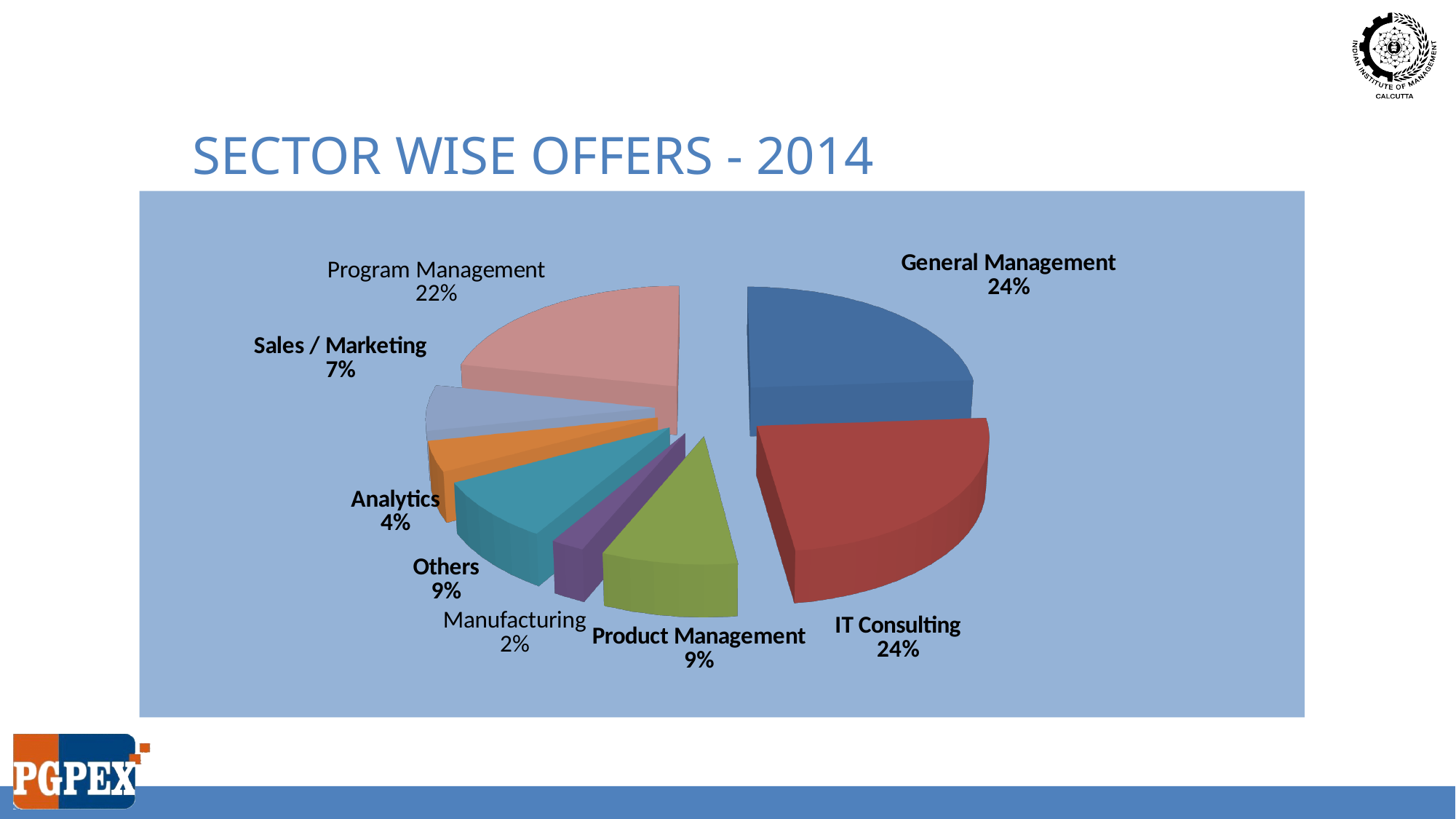
What percentage is shown for Sales / Marketing? 7% Which sector has the smallest share of offers? Manufacturing What is the title of the chart? SECTOR WISE OFFERS - 2014 What share of offers went to IT Consulting? 24% How many sectors are shown in the pie chart? 8 Which has a larger share, Sales / Marketing or Manufacturing? Sales / Marketing What is the combined share of General Management and IT Consulting? 48% What kind of chart is shown on the slide? Pie chart What is the difference in percentage points between General Management and Program Management? 2 Which has a larger share, Others or Analytics? Others What percentage is shown for Analytics? 4% What share of offers went to Program Management? 22%